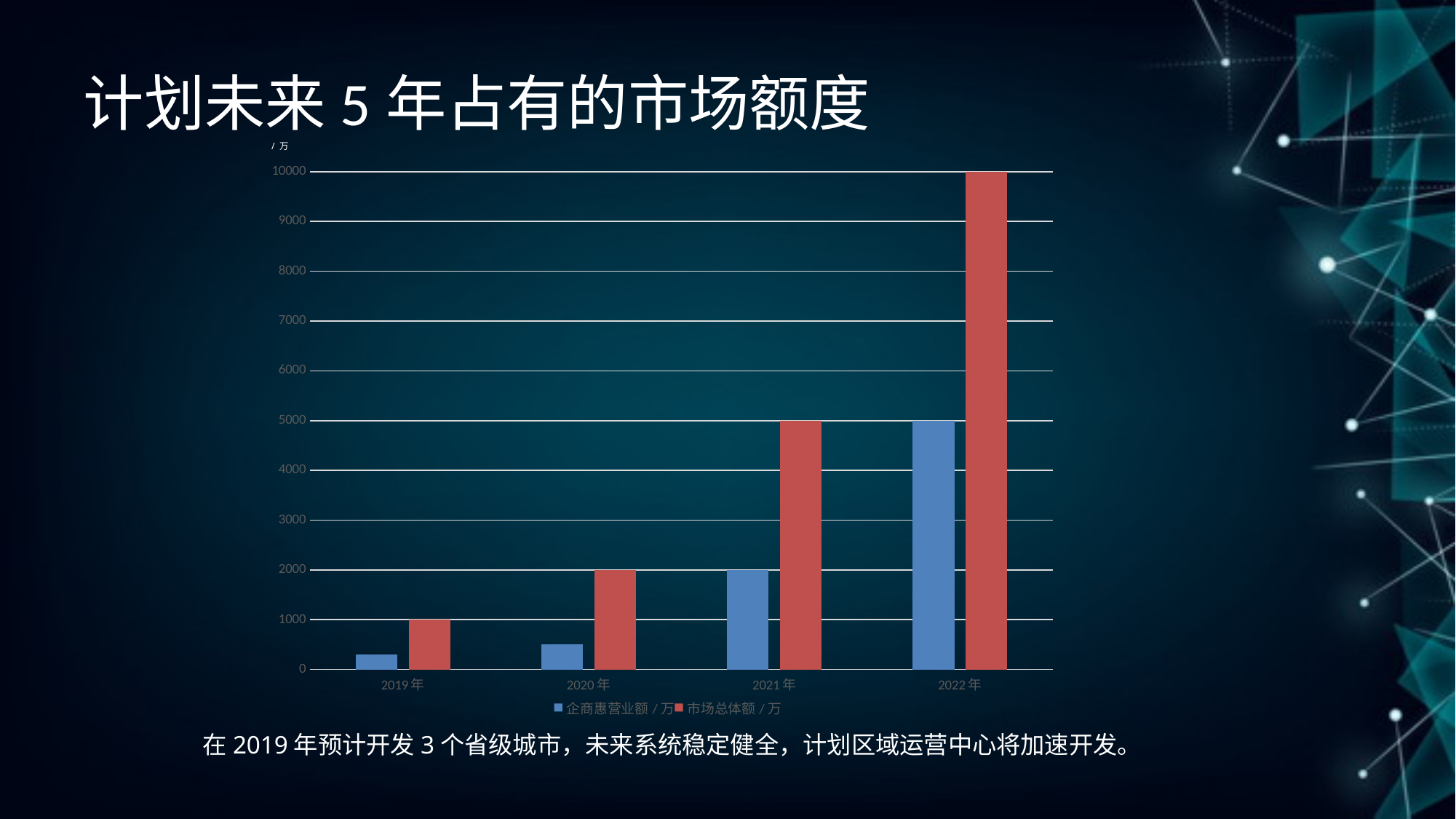
In which year is 市场总体额 / 万 the highest? 2022年 What is the value of 企商惠营业额 / 万 for 2021年? 2000 Do the values of 市场总体额 / 万 rise or fall from 2019年 to 2022年? rise What colour are the bars for 市场总体额 / 万? red Is the value of 企商惠营业额 / 万 for 2019年 greater or less than 1000? less In 2021年, which is larger: 市场总体额 / 万 or 企商惠营业额 / 万? 市场总体额 / 万 What is the value of 市场总体额 / 万 for 2019年? 1000 What kind of chart is shown on the slide? bar chart What is the difference between 市场总体额 / 万 and 企商惠营业额 / 万 in 2022年? 5000 What is the value of 市场总体额 / 万 for 2022年? 10000 How many years are shown on the x axis? 4 How many series does the legend list? 2